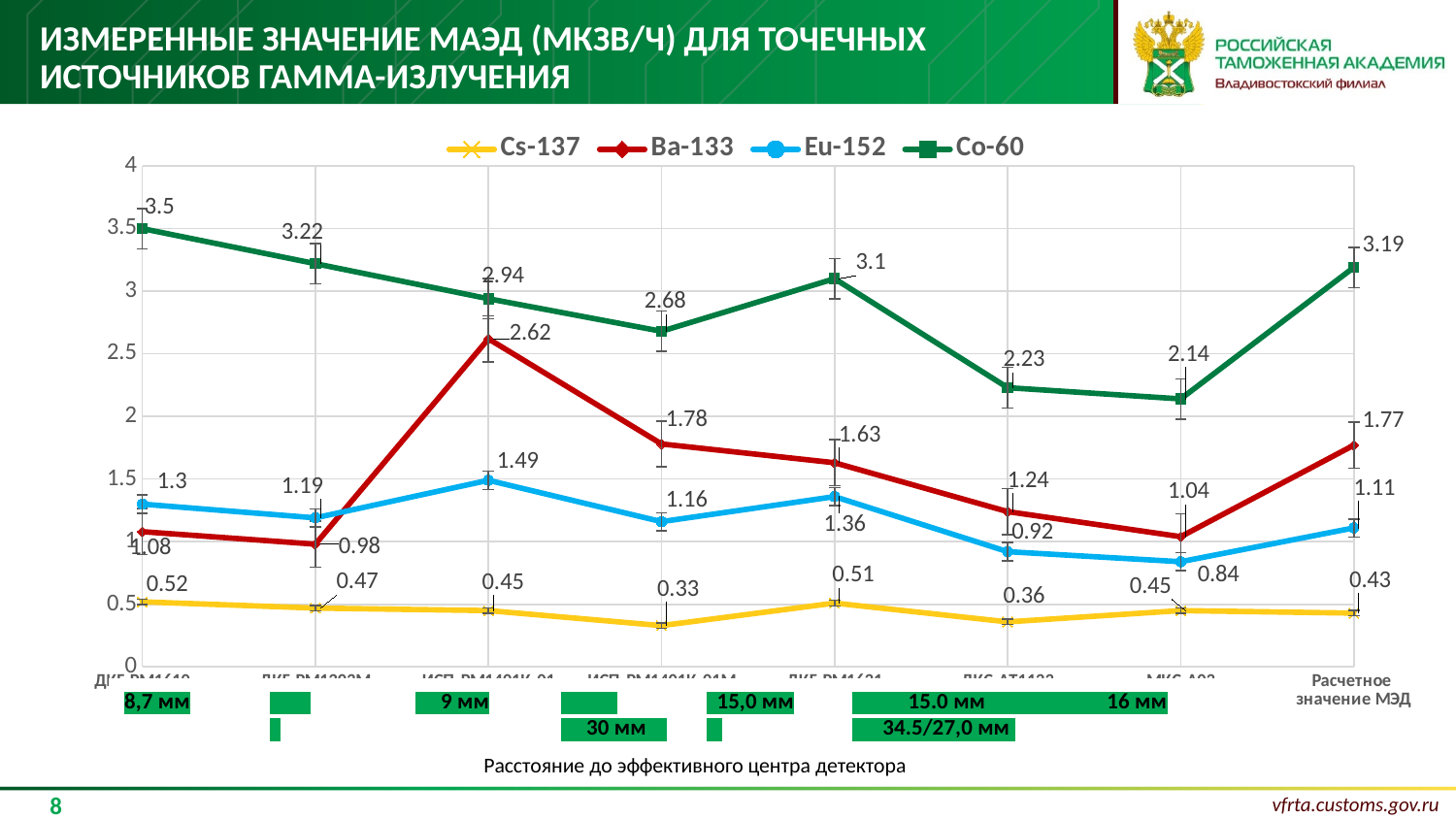
What is the Cs-137 value for the category 'Расчетное значение МЭД'? 0.43 For the category 'Расчетное значение МЭД', what is the difference between the Co-60 value and the Ba-133 value? 1.42 How many data points does each series have along the x axis? 8 What is the lowest value plotted for the Cs-137 series? 0.33 What is the Co-60 value for the category 'Расчетное значение МЭД'? 3.19 What is the Ba-133 value for the category 'Расчетное значение МЭД'? 1.77 What is the highest value plotted for the Co-60 series? 3.5 Which series is drawn in yellow? Cs-137 What is the highest value plotted for the Ba-133 series? 2.62 What kind of chart is shown on the slide? line chart How many series does the legend list? 4 What is the Eu-152 value for the category 'Расчетное значение МЭД'? 1.11